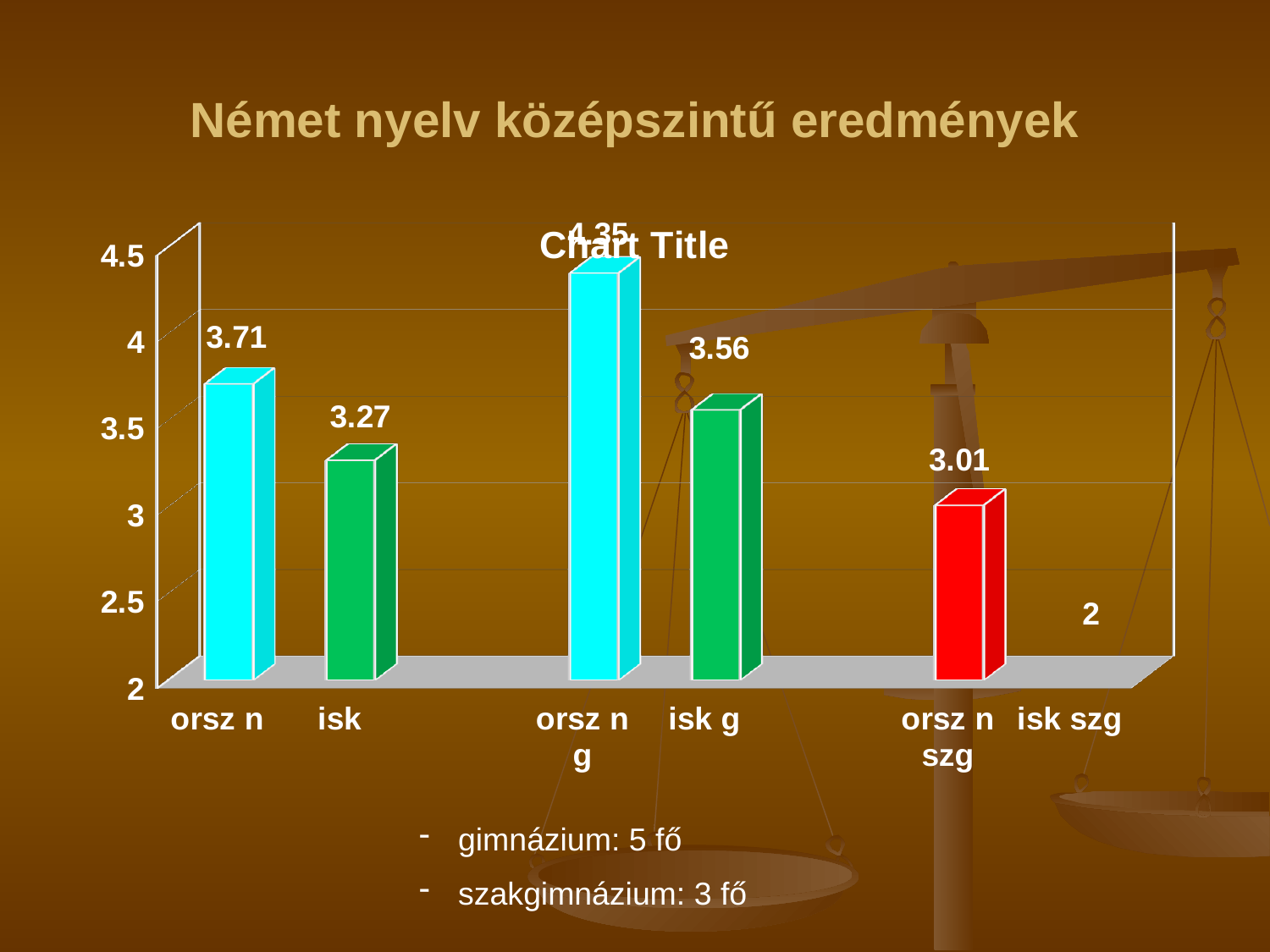
Which category has the highest value? orsz n g What is the value for orsz n szg? 3.01 What is the value for isk g? 3.56 Which category has the lowest value? isk szg Which is larger, the value for orsz n szg or the value for isk szg? orsz n szg How many categories are shown on the x axis? 6 What is the difference between the values for orsz n g and isk g? 0.79 What is the title of the slide? Német nyelv középszintű eredmények What kind of chart is shown on the slide? bar chart What is the difference between the values for orsz n and isk? 0.44 What is the value for isk? 3.27 What is the value for orsz n g? 4.35